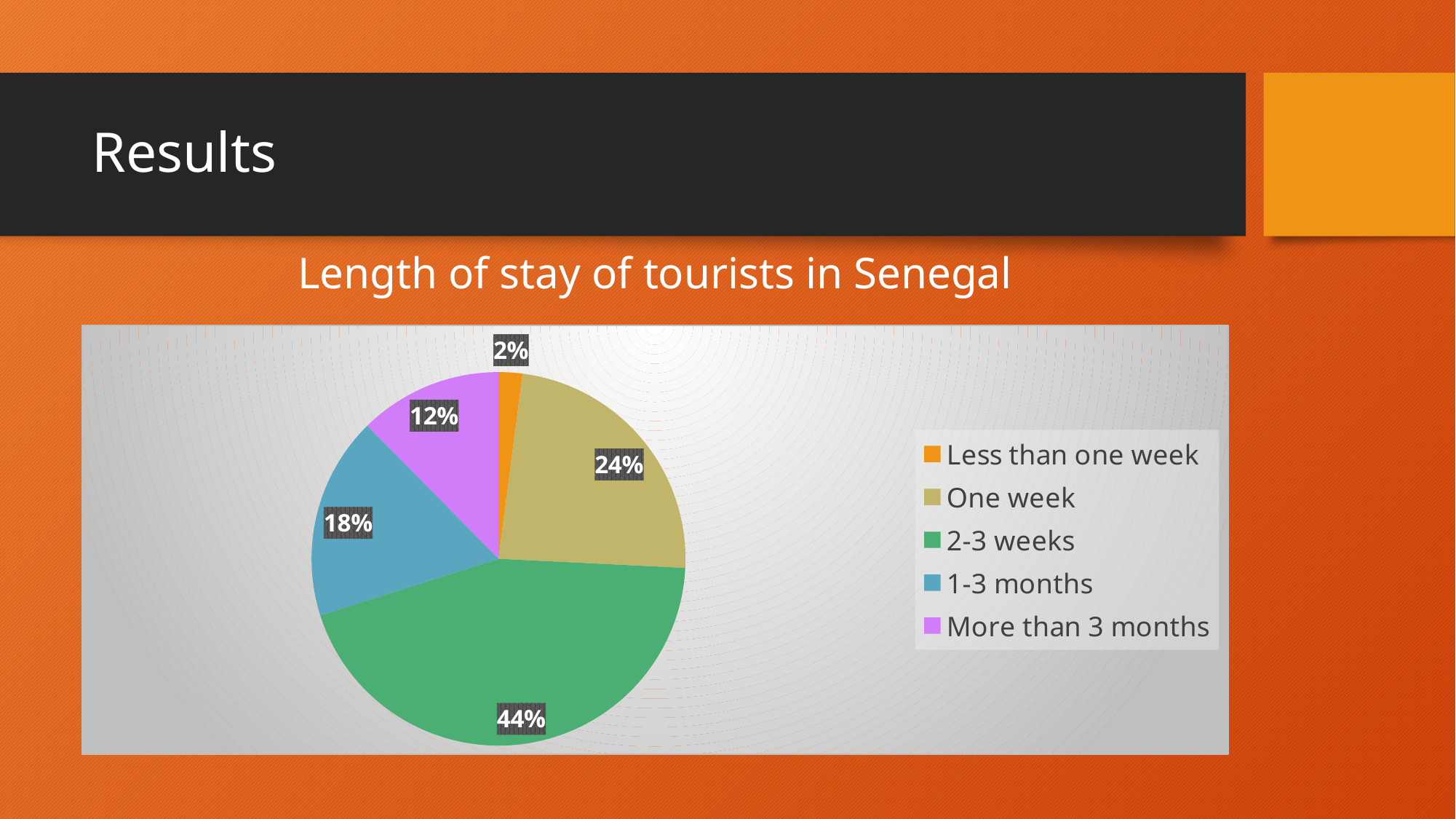
Which is larger, the share for 1-3 months or the share for more than 3 months? 1-3 months Which length of stay has the largest share of tourists? 2-3 weeks What share of tourists stayed less than one week? 2% What is the title of the chart? Length of stay of tourists in Senegal What share of tourists stayed one week? 24% How many slices does the pie chart have? 5 What share of tourists stayed 1-3 months? 18% What share of tourists stayed more than 3 months? 12% What is the difference in percentage points between the 2-3 weeks slice and the one week slice? 20 What kind of chart is shown on the slide? Pie chart What share of tourists stayed 2-3 weeks? 44% Which length of stay has the smallest share of tourists? Less than one week